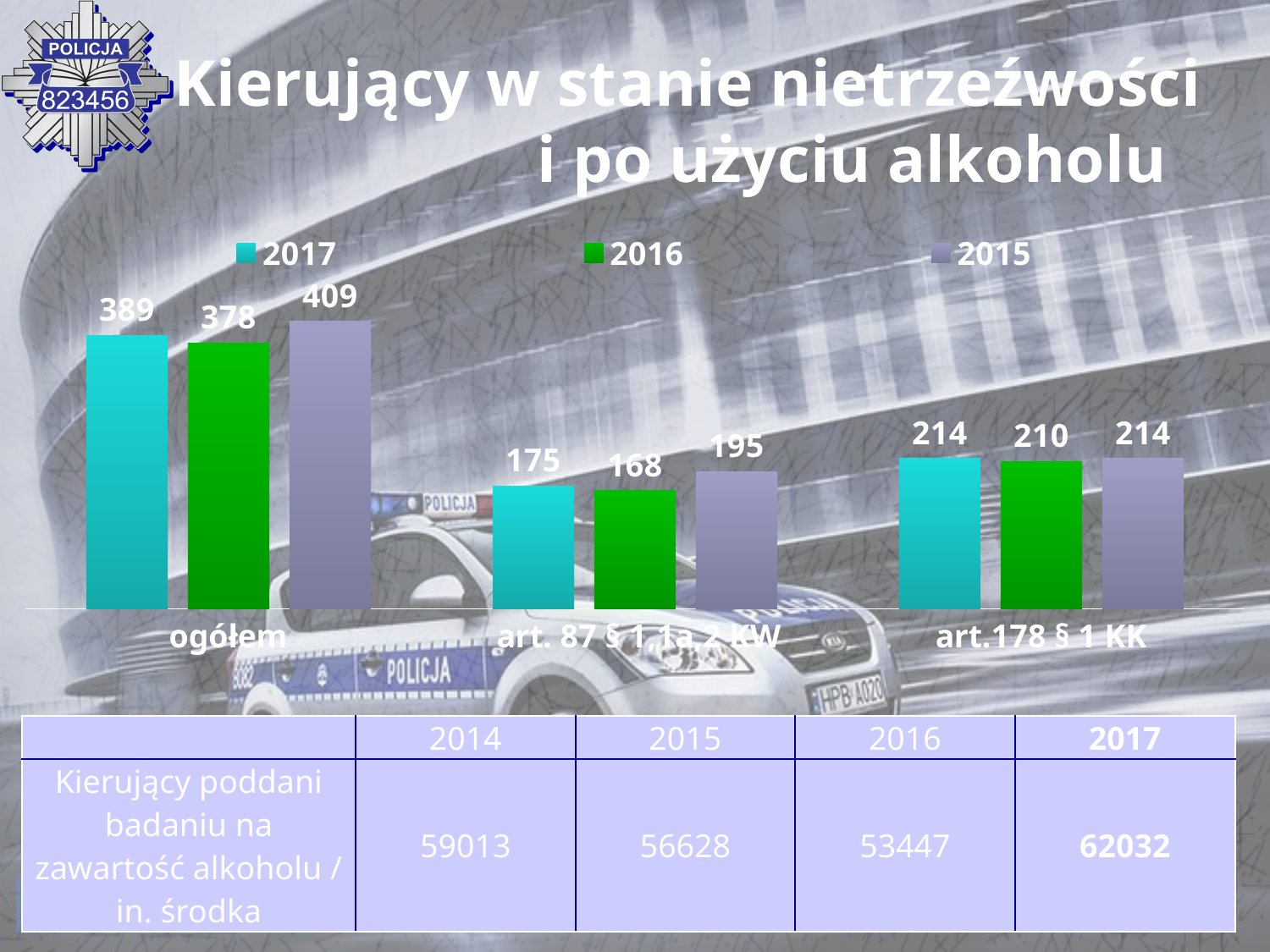
What is the value for 2016 in the "art.178 § 1 KK" category? 210 Which year has the highest value in the "ogółem" category? 2015 What is the difference between the 2017 and 2016 values in the "art. 87 § 1,1a,2 KW" category? 7 How many series does the chart legend list? 3 What is the value for 2015 in the "art. 87 § 1,1a,2 KW" category? 195 Which colour represents the 2016 series in the chart? green Which is larger: the 2017 value for "ogółem" or the 2016 value for "ogółem"? 2017 What is the difference between the 2015 and 2017 values in the "ogółem" category? 20 How many categories are shown on the x axis of the chart? 3 Which year has the lowest value in the "art. 87 § 1,1a,2 KW" category? 2016 What kind of chart is shown on the slide? bar chart What is the value for 2017 in the "ogółem" category? 389